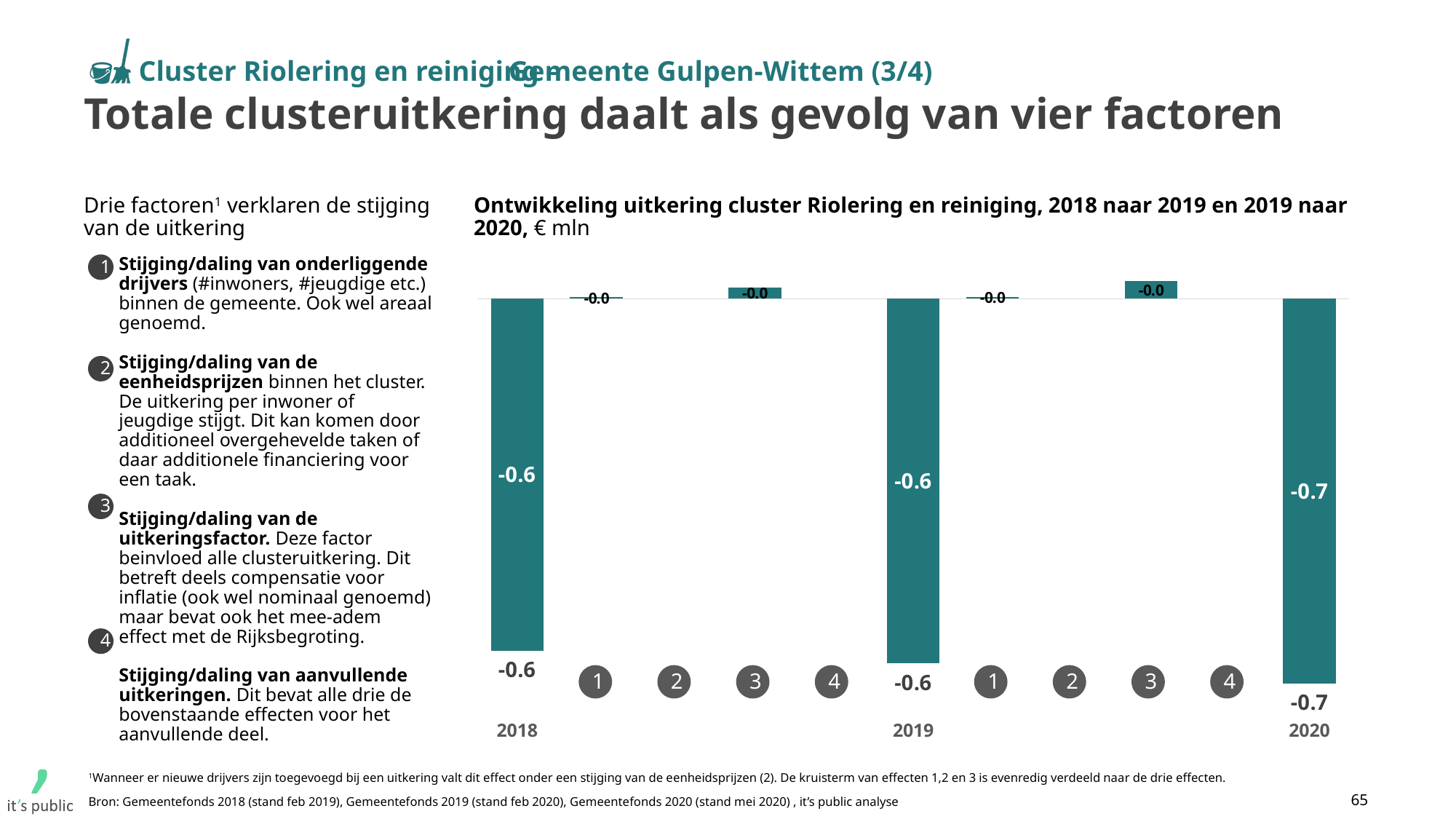
What is the value of the total bar for 2020? -0.7 Which total is more negative, 2019 or 2020? 2020 What kind of chart is shown on the slide? bar chart What is the value of the total bar for 2019? -0.6 How many year totals (2018, 2019, 2020) are shown in the chart? 3 Which year has the lowest (most negative) total value? 2020 What is the difference between the total values for 2018 and 2020? 0.1 What is the title of the chart? Ontwikkeling uitkering cluster Riolering en reiniging, 2018 naar 2019 en 2019 naar 2020 How many numbered factor bars are shown between the 2018 and 2019 totals? 4 Does the total value rise or fall from 2018 to 2020? fall What is the value of the total bar for 2018? -0.6 In what unit are the chart values expressed? € mln